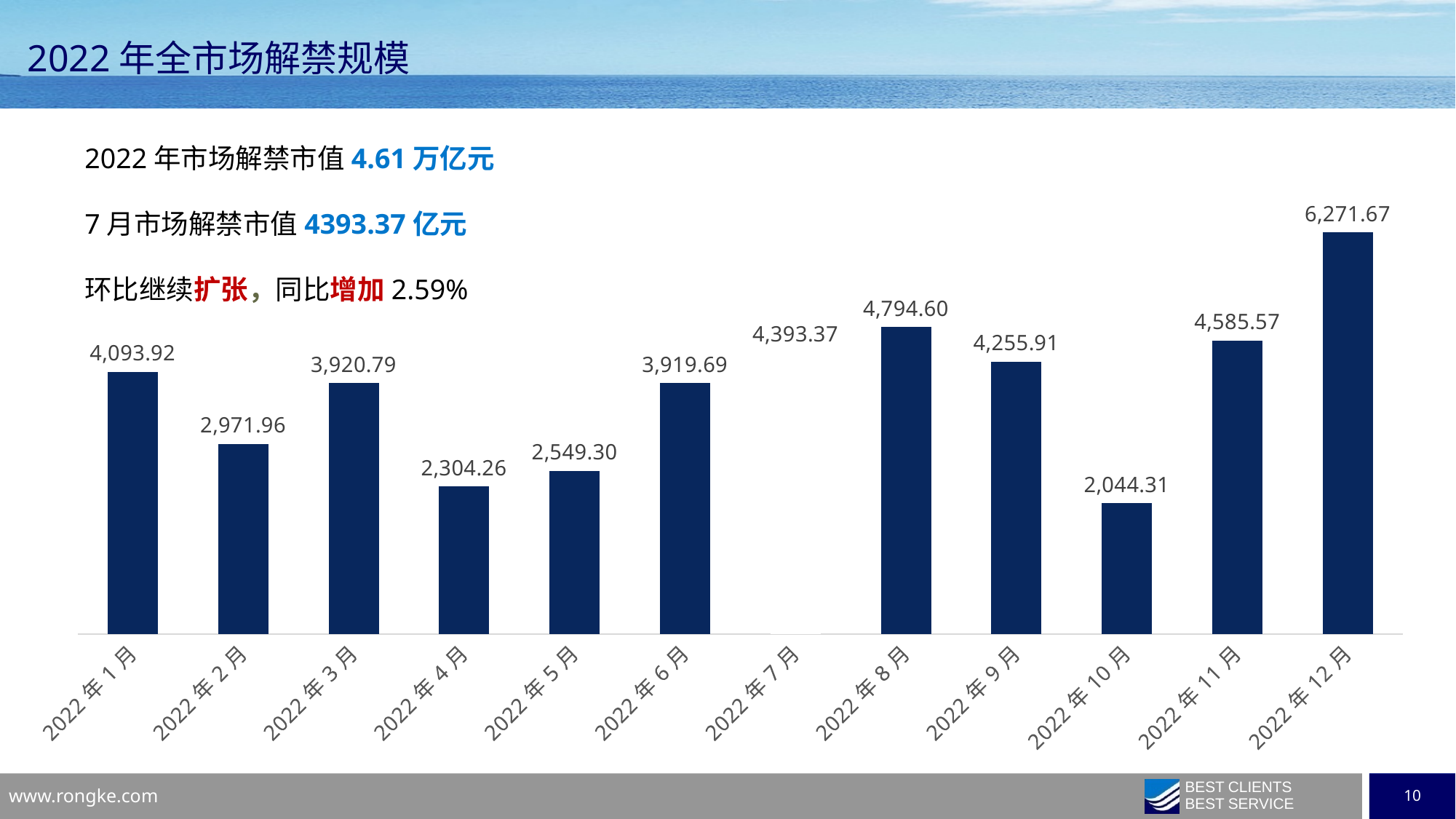
What is the value for 2022 年 10 月? 2,044.31 What is the difference between the values for 2022 年 1 月 and 2022 年 2 月? 1,121.96 What is the value for 2022 年 1 月? 4,093.92 Which month has the highest value in the chart? 2022 年 12 月 What is the title of the slide's chart? 2022 年全市场解禁规模 Which is larger, the value for 2022 年 8 月 or 2022 年 9 月? 2022 年 8 月 What type of chart is shown on the slide? bar chart Which month has the lowest value in the chart? 2022 年 10 月 Do the values rise or fall from 2022 年 10 月 to 2022 年 12 月? rise What is the difference between the values for 2022 年 12 月 and 2022 年 10 月? 4,227.36 How many months (categories) are shown on the x axis of the chart? 12 What is the value for 2022 年 7 月? 4,393.37